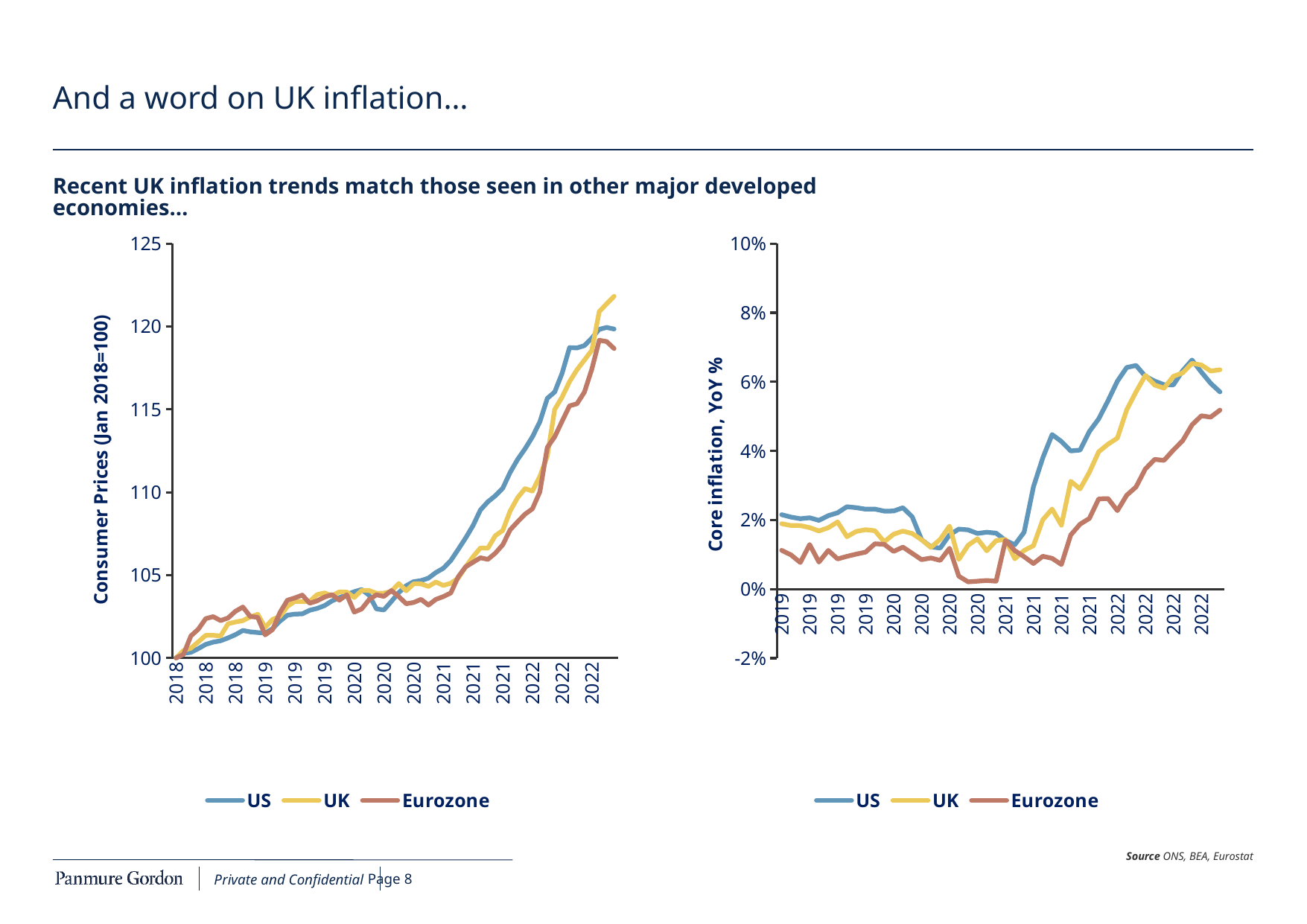
Which series are listed in the legend of the right chart? US, UK, Eurozone What kind of chart is the right chart (Core inflation, YoY %)? line chart In the left chart, do consumer prices generally rise or fall from 2018 to 2022? rise What kind of chart is the left chart (Consumer Prices)? line chart In the left chart, is the final Eurozone value greater or less than 120? less How many series does the legend of the left chart list? 3 What is the y-axis title of the right chart? Core inflation, YoY % In the left chart, which series has the highest value at the end of 2022? UK In the left chart, what value do all three series start at in 2018? 100 In the left chart, is the final UK value greater or less than 120? greater In the right chart, is the final Eurozone core inflation value greater or less than 6%? less In the right chart, which series has the lowest core inflation at the end of 2022? Eurozone